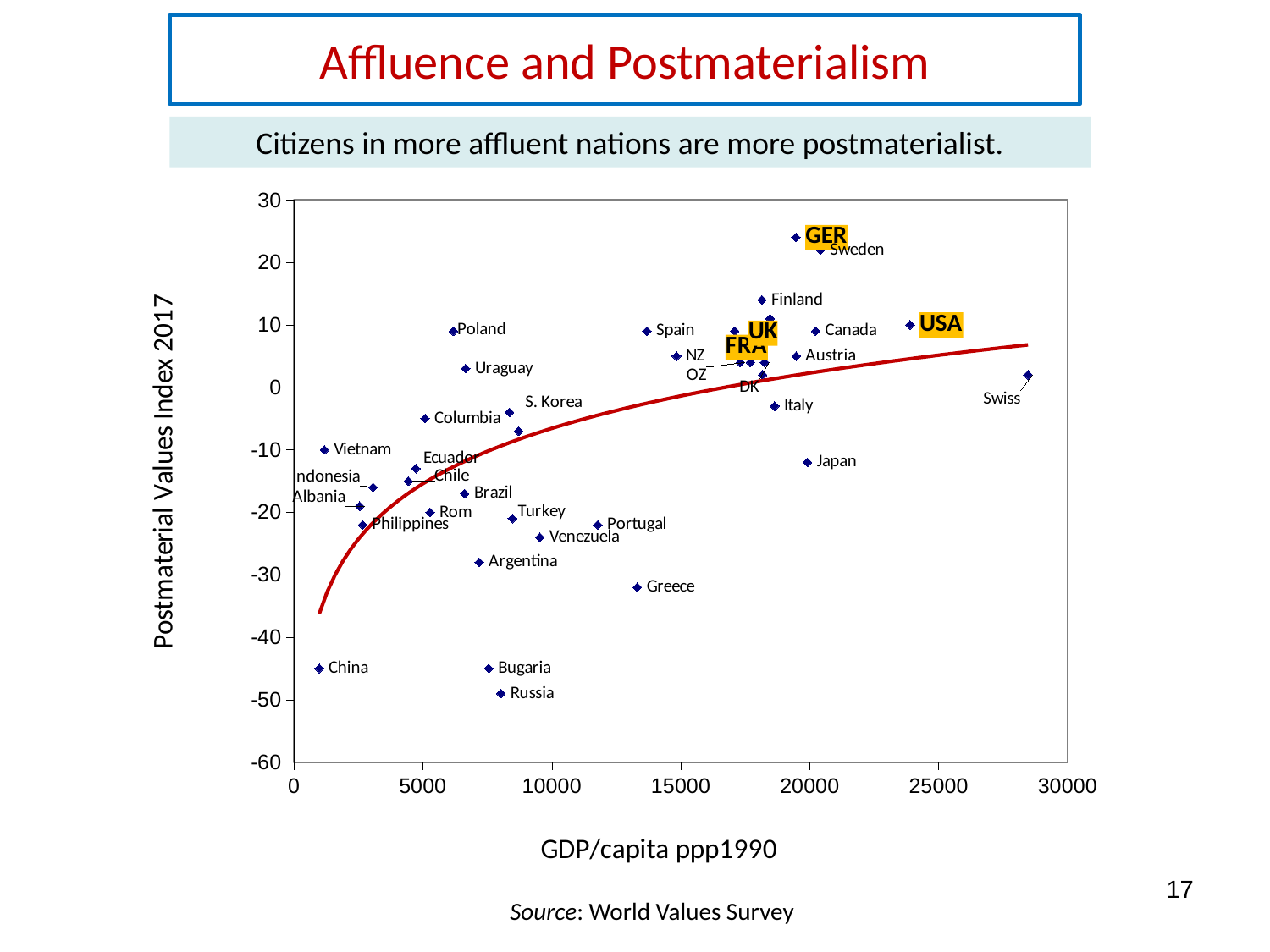
Which country has the lowest Postmaterial Values Index on the chart? Russia Does the Postmaterial Values Index generally rise or fall as GDP/capita increases? rise What kind of chart is shown on the slide? Scatter chart Which has a higher Postmaterial Values Index, Poland or Uruguay? Poland Which country has the highest GDP/capita on the chart? Swiss What is the label of the x axis? GDP/capita ppp1990 Is the Postmaterial Values Index for Finland greater or less than 10? greater Is the Postmaterial Values Index for Japan greater or less than 0? less Is the Postmaterial Values Index for Swiss greater or less than 10? less Which country has the highest Postmaterial Values Index on the chart? GER Which has a higher Postmaterial Values Index, Italy or Japan? Italy